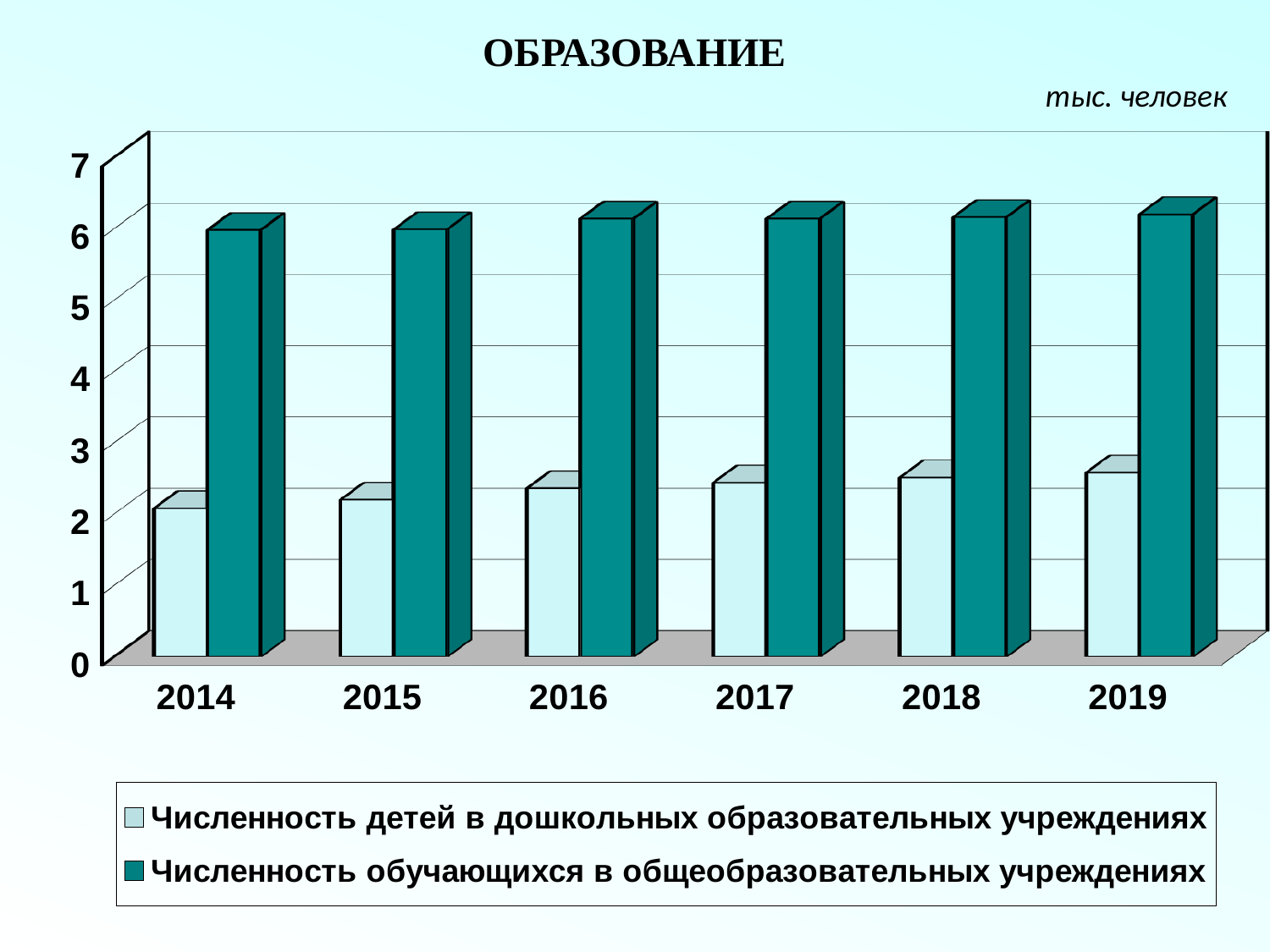
Is the value for Численность обучающихся в общеобразовательных учреждениях in 2016 greater or less than 5? greater Which year has the lowest value for Численность детей в дошкольных образовательных учреждениях? 2014 Does the number of children in preschool educational institutions (Численность детей в дошкольных образовательных учреждениях) rise or fall from 2014 to 2019? rise Is the value for Численность обучающихся в общеобразовательных учреждениях in 2019 greater or less than 7? less How many series does the legend list? 2 In what units are the values on the chart expressed? тыс. человек How many years are shown on the x axis of the chart? 6 Is the value for Численность детей в дошкольных образовательных учреждениях in 2014 greater or less than 3? less In 2017, which series has the larger value: Численность детей в дошкольных образовательных учреждениях or Численность обучающихся в общеобразовательных учреждениях? Численность обучающихся в общеобразовательных учреждениях What is the title of the chart? ОБРАЗОВАНИЕ What kind of chart is shown on the slide? bar chart Which year has the highest value for Численность детей в дошкольных образовательных учреждениях? 2019